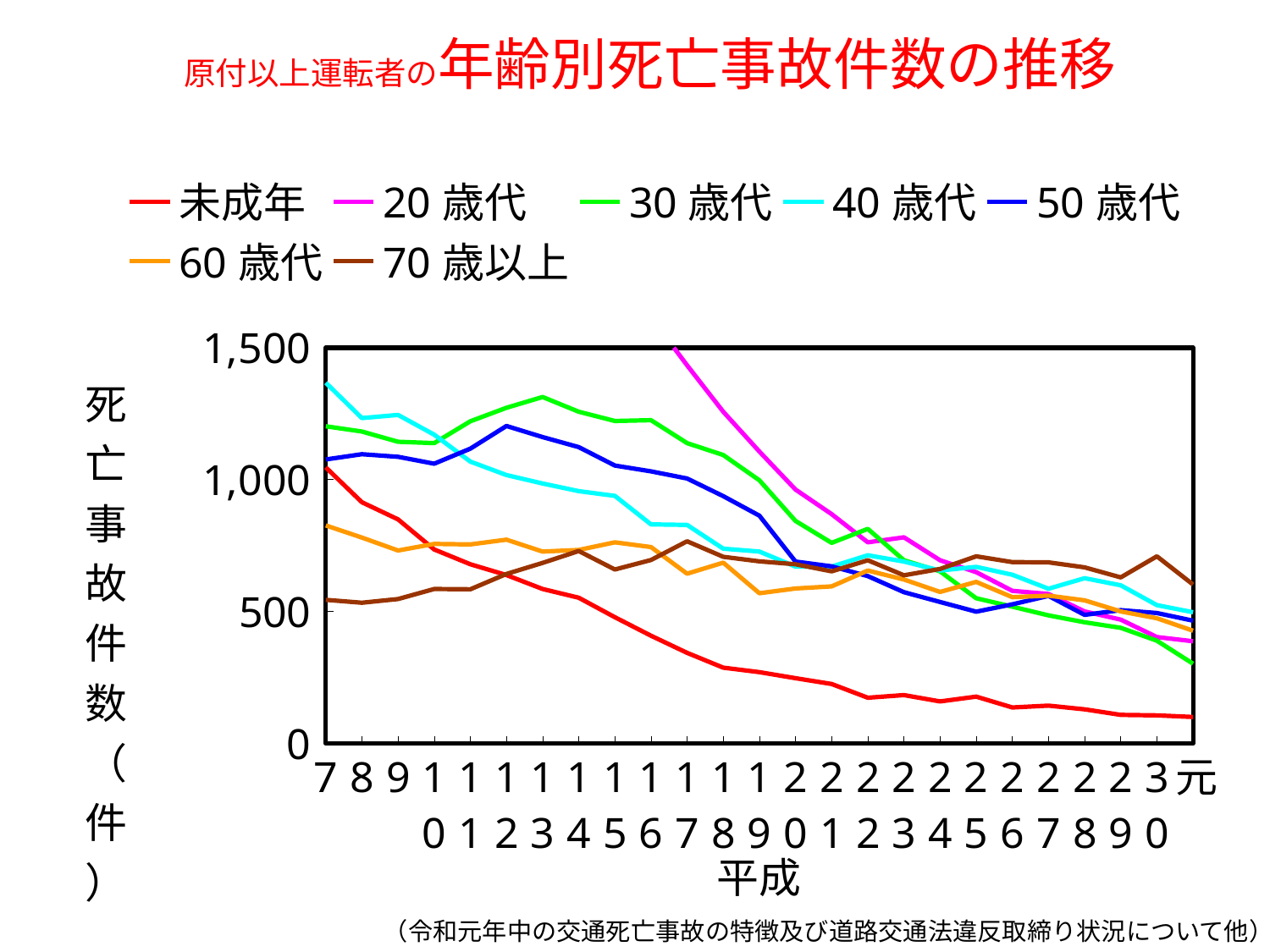
At 平成7, which is higher, 40歳代 or 未成年? 40歳代 What colour is the 未成年 line in the legend? red Is the value for 未成年 at 令和元 greater or less than 500? less How many points along the x axis does each line have? 25 Is the value for 30歳代 at 平成13 greater or less than 1,000? greater Which series has the lowest value at 令和元? 未成年 How many series does the legend list? 7 What kind of chart is shown on the slide? line chart Does the 未成年 line rise or fall from 平成7 to 令和元? fall Is the value for 70歳以上 at 平成7 greater or less than 1,000? less At 令和元, which is higher, 30歳代 or 70歳以上? 70歳以上